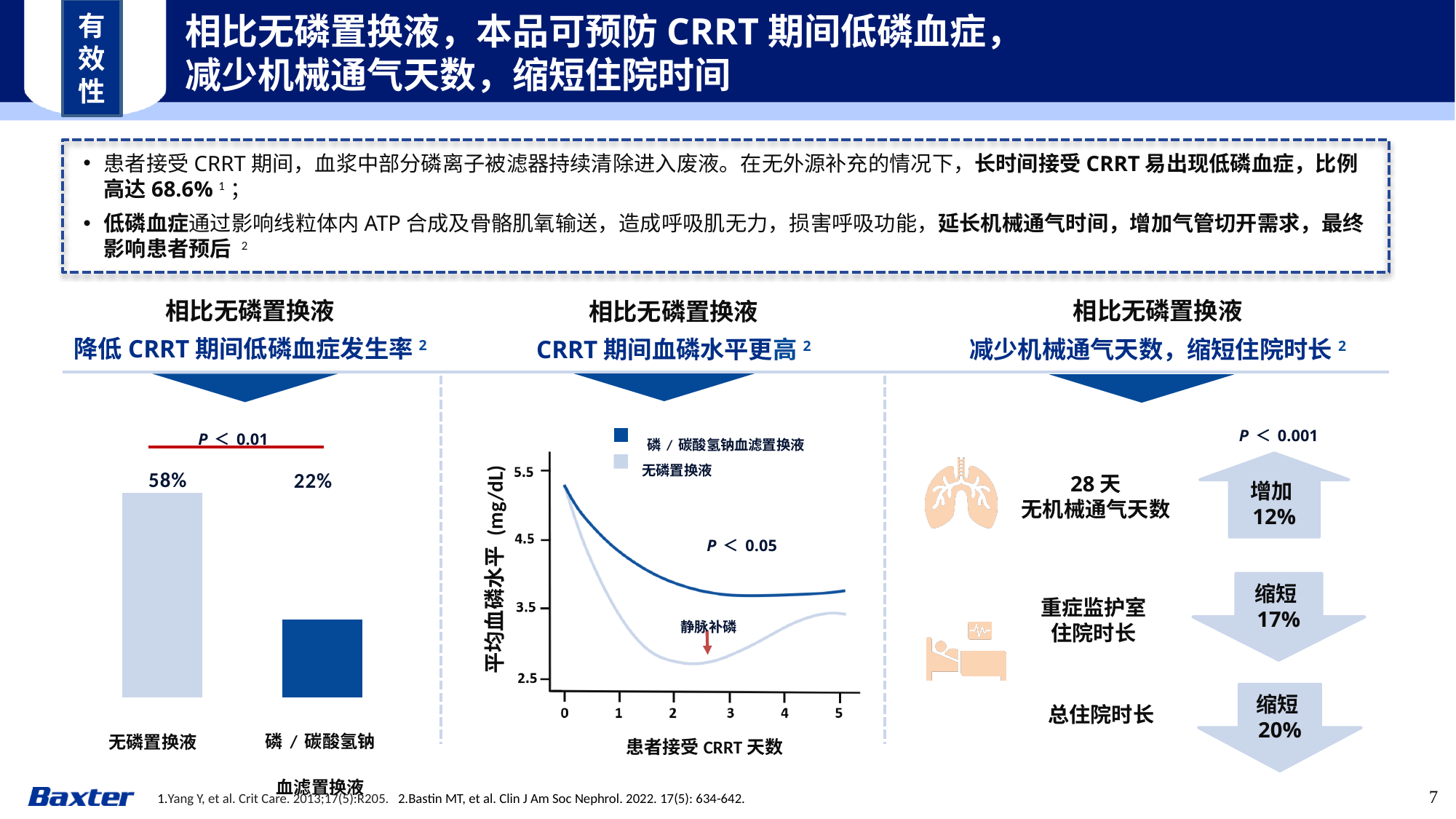
In the bar chart on the left, what is the difference between the 无磷置换液 bar and the 磷／碳酸氢钠血滤置换液 bar? 36% In the bar chart on the left (降低 CRRT 期间低磷血症发生率), what is the value for 无磷置换液? 58% In the middle line chart, does the 磷／碳酸氢钠血滤置换液 line rise or fall from day 0 to day 5? fall In the bar chart on the left, which category has the higher value? 无磷置换液 What kind of chart is the chart in the middle of the slide (平均血磷水平 vs 患者接受 CRRT 天数)? line chart What kind of chart is the chart on the left of the slide? bar chart How many bars are shown in the bar chart on the left? 2 How many series does the legend of the middle line chart list? 2 In the bar chart on the left, what is the value for 磷／碳酸氢钠血滤置换液? 22% In the middle line chart, at day 5 is the value for 磷／碳酸氢钠血滤置换液 greater or less than 3.5? greater In the middle line chart, at day 2 is the value for 无磷置换液 greater or less than 3.5? less What P value is printed above the bar chart on the left? P < 0.01